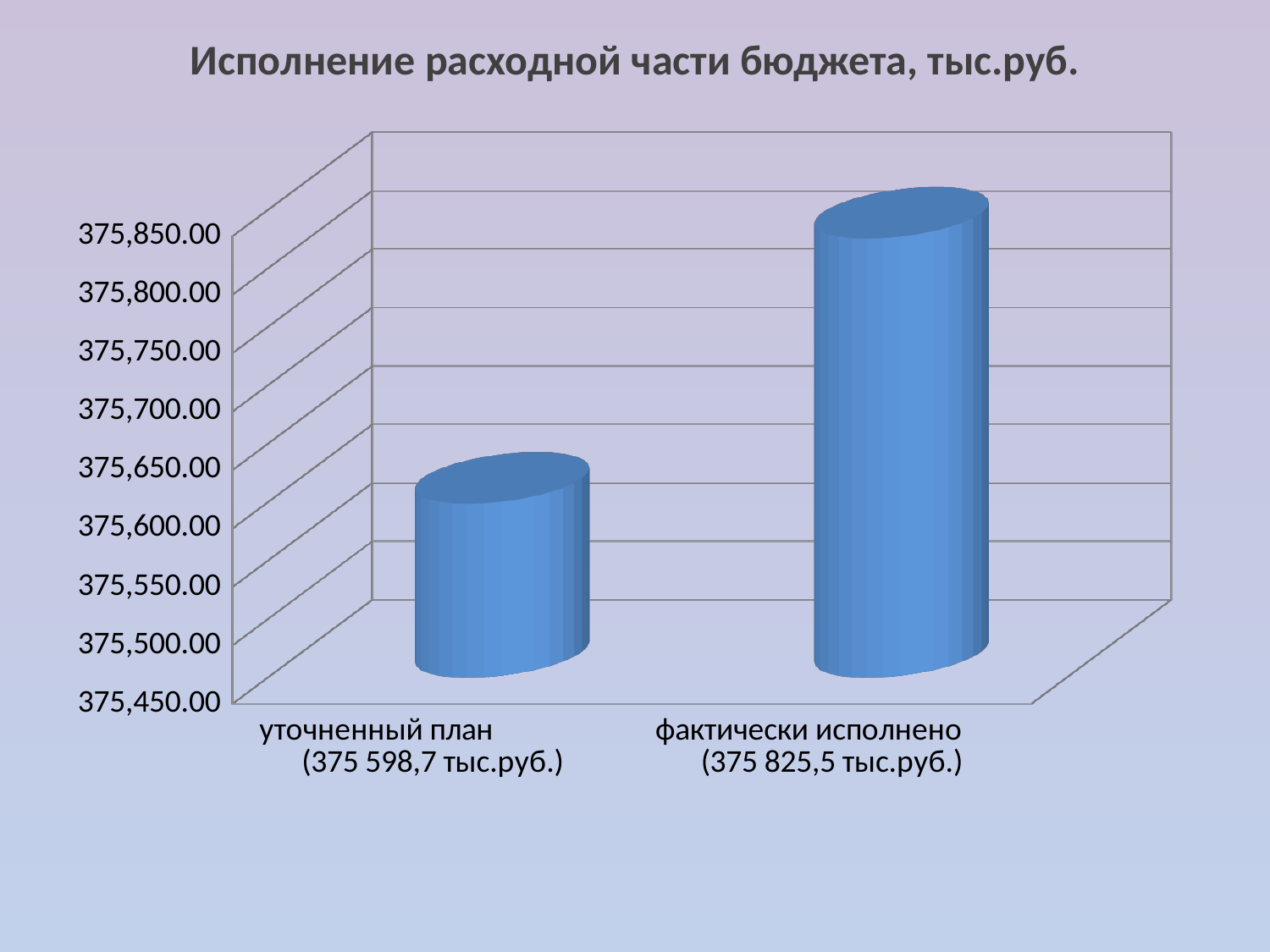
Is the value for 'фактически исполнено' greater or less than 375,800.00? greater What is the value for 'уточненный план' as printed in its category label? 375 598,7 тыс.руб. By how much does 'фактически исполнено' exceed 'уточненный план', in тыс.руб.? 226,8 Which category has the higher value? фактически исполнено Is the bar for 'уточненный план' taller or shorter than the bar for 'фактически исполнено'? shorter Which category has the lower value? уточненный план What kind of chart is shown on the slide? bar chart Is the value for 'уточненный план' greater or less than 375,650.00? less What is the title of the chart? Исполнение расходной части бюджета, тыс.руб. What is the value for 'фактически исполнено' as printed in its category label? 375 825,5 тыс.руб. How many categories are shown on the chart? 2 Do the values rise or fall from left to right along the x axis? rise